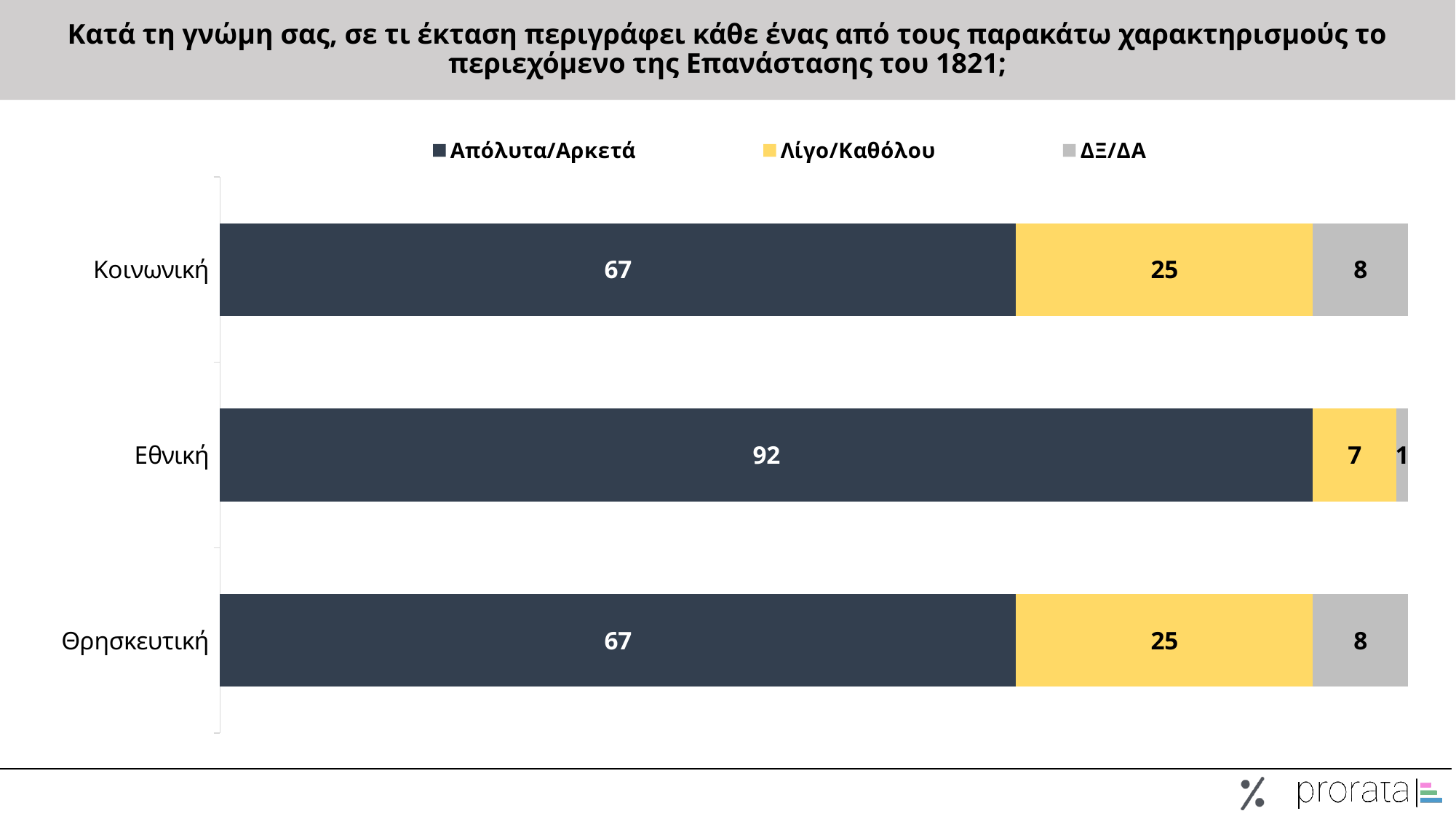
What kind of chart is shown on the slide? Stacked bar chart Which category has the highest value for Απόλυτα/Αρκετά? Εθνική What is the value for ΔΞ/ΔΑ for Θρησκευτική? 8 What is the total of the stacked bar for Εθνική? 100 How many series does the legend list? 3 What is the difference between the Απόλυτα/Αρκετά values for Εθνική and Κοινωνική? 25 Which category has the lowest value for Λίγο/Καθόλου? Εθνική What is the value for Απόλυτα/Αρκετά for Εθνική? 92 Which is larger: the Λίγο/Καθόλου value for Θρησκευτική or for Εθνική? Θρησκευτική What is the value for Λίγο/Καθόλου for Κοινωνική? 25 What is the value for ΔΞ/ΔΑ for Εθνική? 1 How many categories are shown in the chart? 3